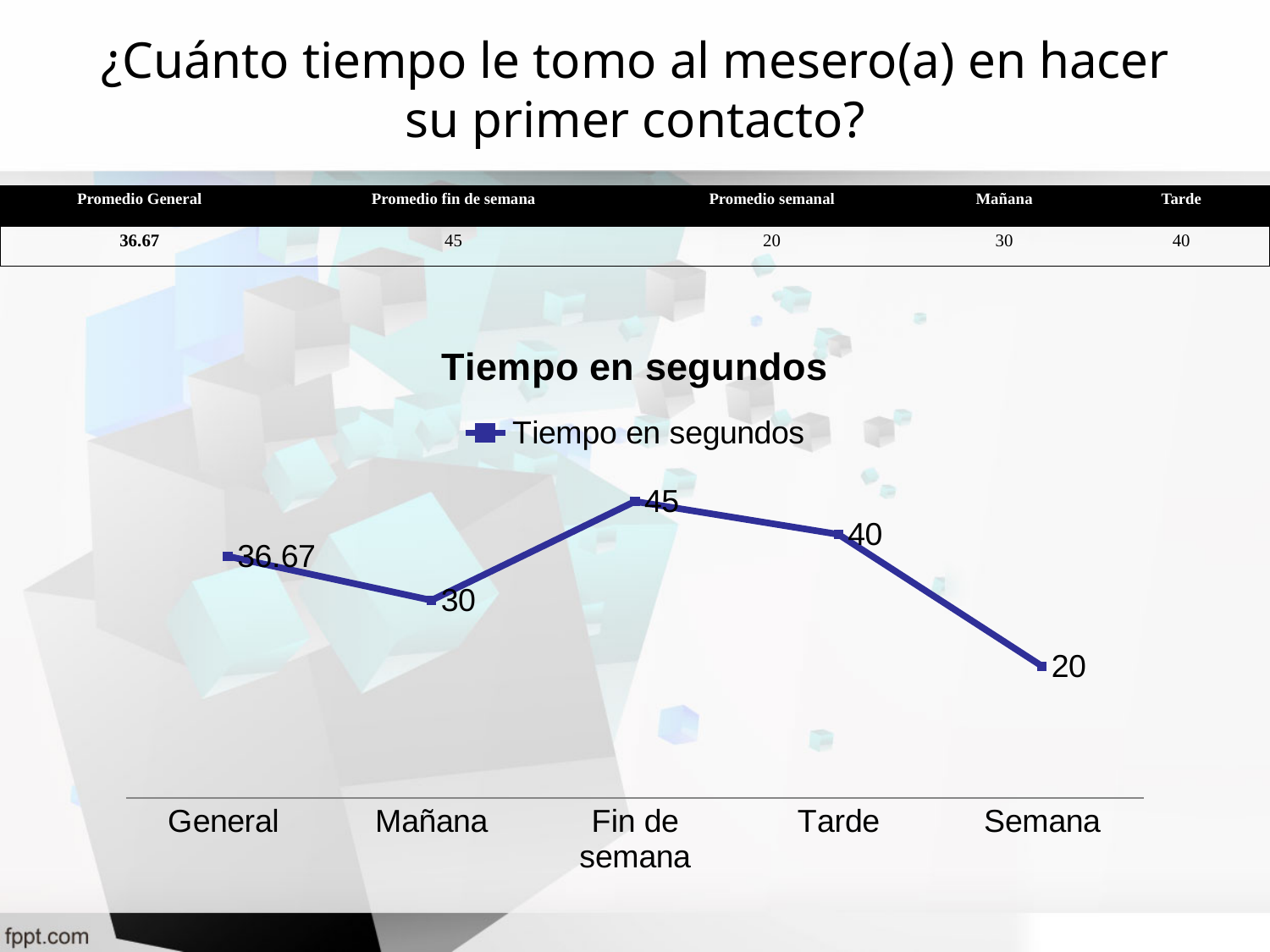
What is the value for Semana in the chart? 20 How many series does the chart legend list? 1 Which category has the highest value in the chart? Fin de semana How many categories are plotted on the x axis of the chart? 5 What is the difference between the values for Tarde and Mañana? 10 What is the value for General in the chart? 36.67 What is the difference between the values for Fin de semana and Semana? 25 What is the value for Fin de semana in the chart? 45 What kind of chart is shown on the slide? line chart Which category has the lowest value in the chart? Semana Which is larger, the value for Mañana or the value for Tarde? Tarde What is the title of the chart? Tiempo en segundos